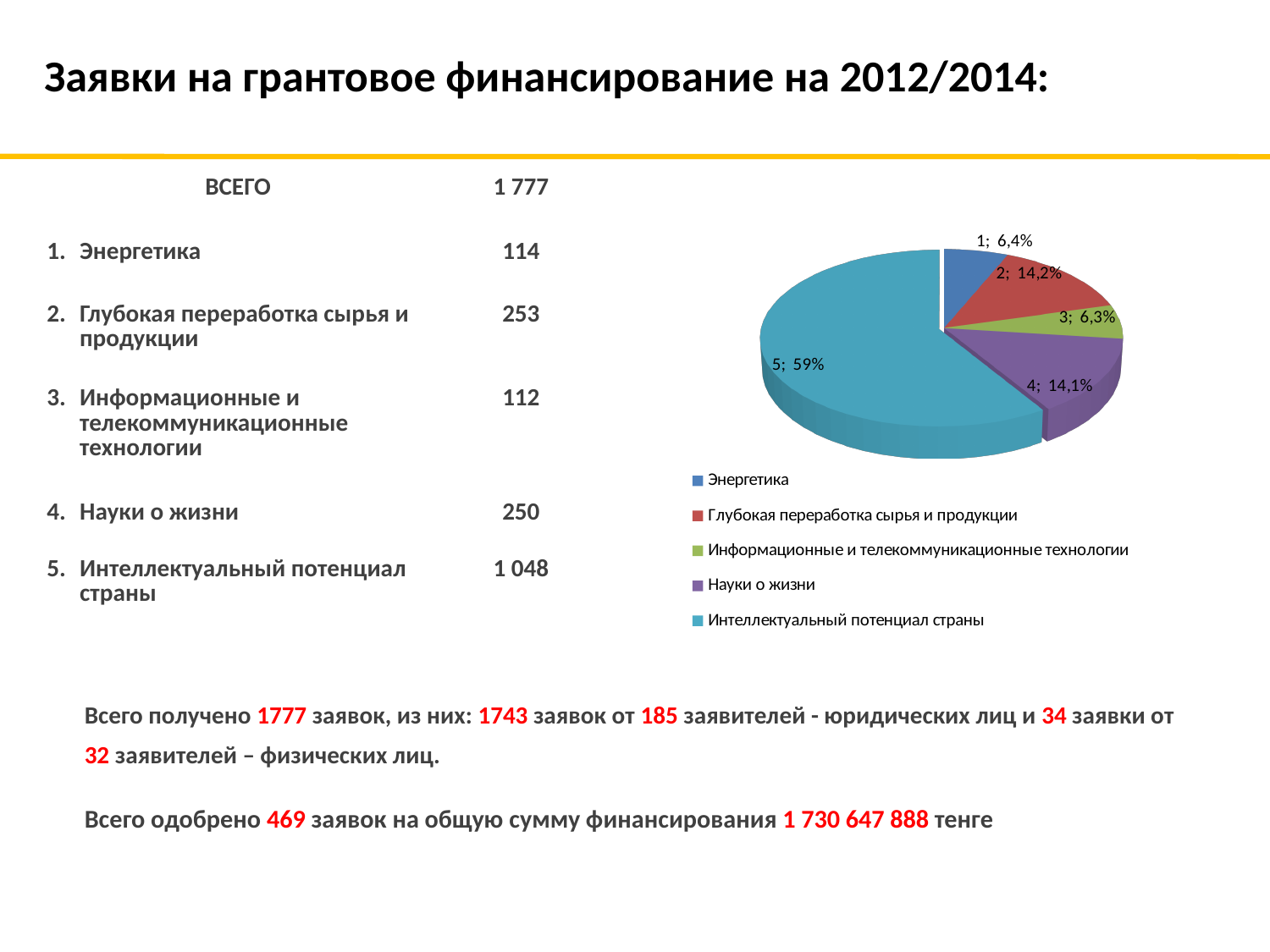
What share of the pie does Глубокая переработка сырья и продукции (slice 2) have? 14,2% What share of the pie does Науки о жизни (slice 4) have? 14,1% What is the difference in percentage points between the share of Интеллектуальный потенциал страны (59%) and Энергетика (6,4%)? 52,6% What colour is used for Энергетика in the pie chart legend? blue How many entries does the legend of the pie chart list? 5 What share of the pie does Информационные и телекоммуникационные технологии (slice 3) have? 6,3% Which category has the largest slice of the pie? Интеллектуальный потенциал страны Which slice is larger: Науки о жизни or Энергетика? Науки о жизни What kind of chart is shown on the slide? pie chart How many slices does the pie chart have? 5